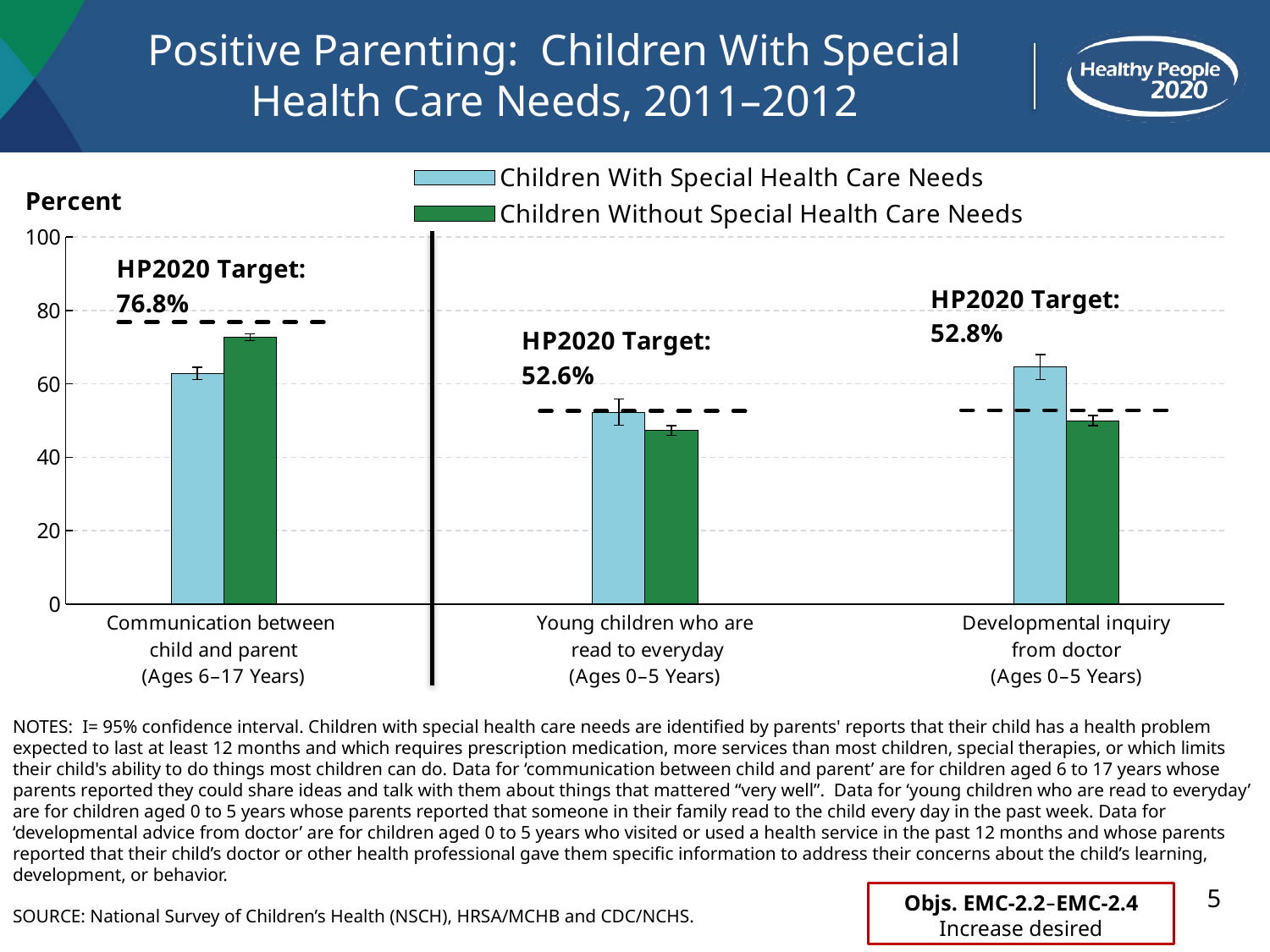
For communication between child and parent, which series has the larger value: Children With Special Health Care Needs or Children Without Special Health Care Needs? Children Without Special Health Care Needs How many series does the legend list? 2 How many categories are shown along the x axis? 3 What is the HP2020 Target for communication between child and parent (ages 6–17 years)? 76.8% For Children Without Special Health Care Needs, which category has the highest value? Communication between child and parent (Ages 6–17 Years) What is the HP2020 Target for young children who are read to everyday (ages 0–5 years)? 52.6% For developmental inquiry from doctor, which series has the larger value: Children With Special Health Care Needs or Children Without Special Health Care Needs? Children With Special Health Care Needs What kind of chart is shown on the slide? bar chart Is the value for Children Without Special Health Care Needs for communication between child and parent greater or less than 80? less Is the value for Children Without Special Health Care Needs for young children who are read to everyday greater or less than 60? less What is the HP2020 Target for developmental inquiry from doctor (ages 0–5 years)? 52.8% Is the value for Children With Special Health Care Needs for communication between child and parent greater or less than 60? greater